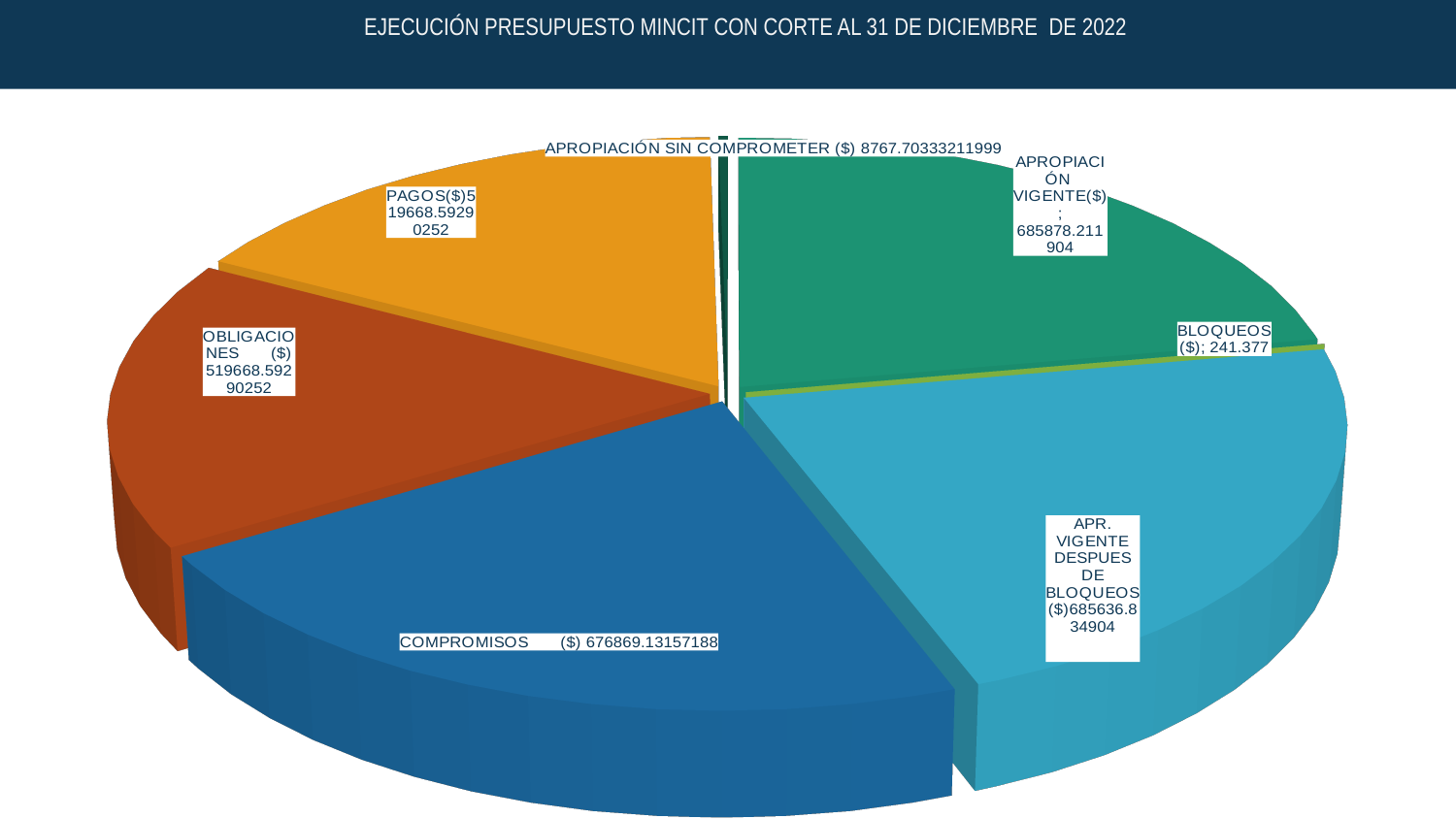
What is the value for COMPROMISOS ($)? 676869.13157188 What is the difference between COMPROMISOS ($) and OBLIGACIONES ($)? 157200.53866936 What is the value for APROPIACIÓN SIN COMPROMETER ($)? 8767.70333211999 What is the title of the slide? EJECUCIÓN PRESUPUESTO MINCIT CON CORTE AL 31 DE DICIEMBRE DE 2022 Which slice has the largest value? APROPIACIÓN VIGENTE ($) Which slice has the smallest value? BLOQUEOS ($) How many slices does the pie chart have? 7 What is the value for BLOQUEOS ($)? 241.377 What kind of chart is shown on the slide? Pie chart Which is larger, COMPROMISOS ($) or PAGOS ($)? COMPROMISOS ($) What is the value for APR. VIGENTE DESPUES DE BLOQUEOS ($)? 685636.834904 What is the value for APROPIACIÓN VIGENTE ($)? 685878.211904